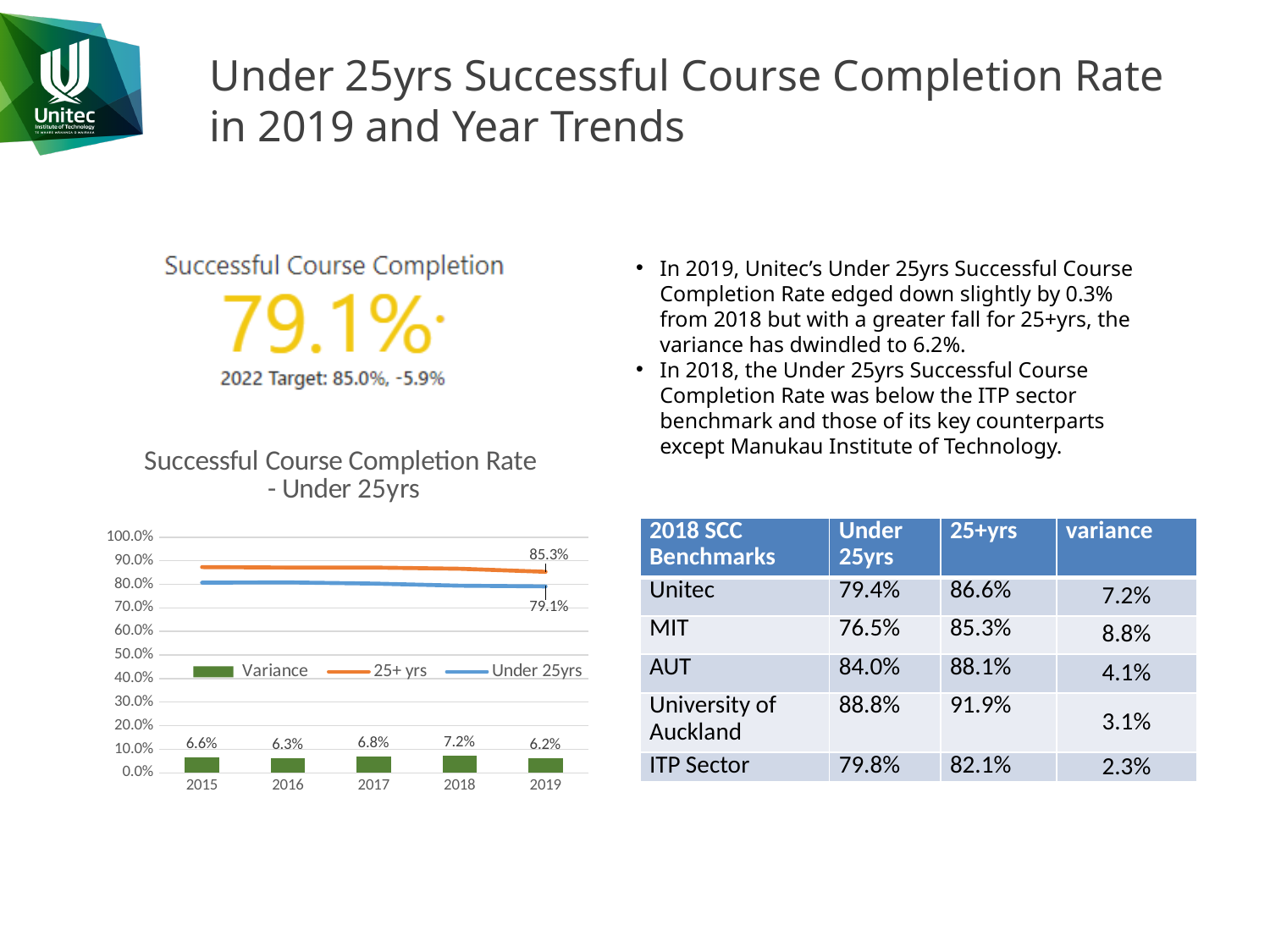
Is the Variance for 2017 larger or smaller than the Variance for 2016 in the Successful Course Completion Rate - Under 25yrs chart? larger In which year is the Variance highest in the Successful Course Completion Rate - Under 25yrs chart? 2018 What is the difference between the 25+ yrs and Under 25yrs values in 2019 in the Successful Course Completion Rate - Under 25yrs chart? 6.2% What is the Variance value for 2018 in the Successful Course Completion Rate - Under 25yrs chart? 7.2% What is the Under 25yrs value for 2019 in the Successful Course Completion Rate - Under 25yrs chart? 79.1% In which year is the Variance lowest in the Successful Course Completion Rate - Under 25yrs chart? 2019 What is the Variance value for 2015 in the Successful Course Completion Rate - Under 25yrs chart? 6.6% How many series does the legend of the Successful Course Completion Rate - Under 25yrs chart list? 3 How many years are shown on the x axis of the Successful Course Completion Rate - Under 25yrs chart? 5 Does the Under 25yrs line rise or fall from 2015 to 2019 in the Successful Course Completion Rate - Under 25yrs chart? fall Is the Under 25yrs value for 2015 greater or less than 70.0% in the Successful Course Completion Rate - Under 25yrs chart? greater What is the 25+ yrs value for 2019 in the Successful Course Completion Rate - Under 25yrs chart? 85.3%